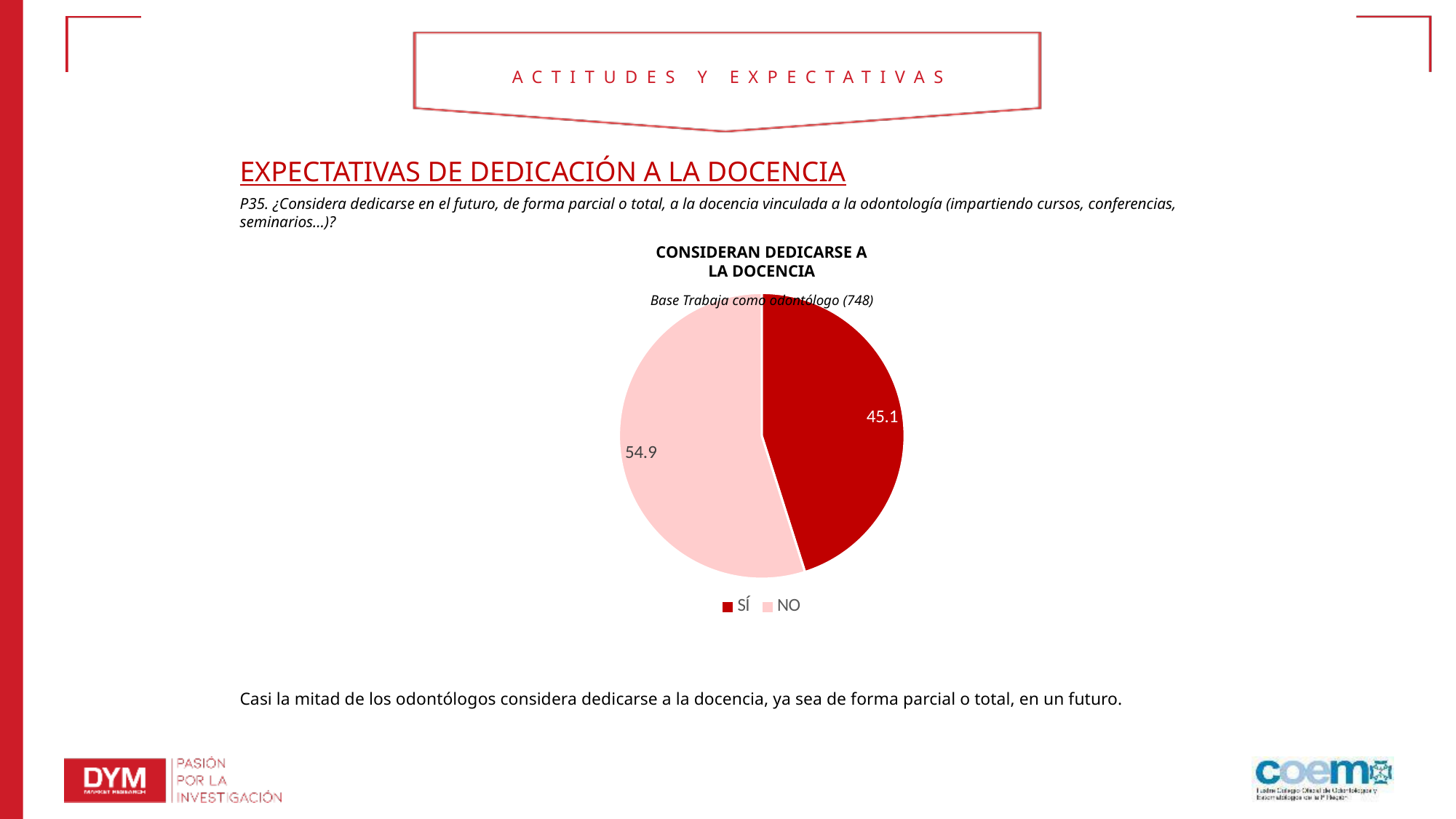
What is the value for SÍ in the pie chart? 45.1 Which slice of the pie chart is the largest? NO How many entries does the legend of the pie chart list? 2 What is the difference between the NO and SÍ values in the pie chart? 9.8 What kind of chart is shown on the slide? pie chart What is the title of the pie chart? CONSIDERAN DEDICARSE A LA DOCENCIA Which is larger in the pie chart, SÍ or NO? NO What base size is stated for the pie chart? 748 What is the value for NO in the pie chart? 54.9 Which slice of the pie chart is the smallest? SÍ How many slices does the pie chart have? 2